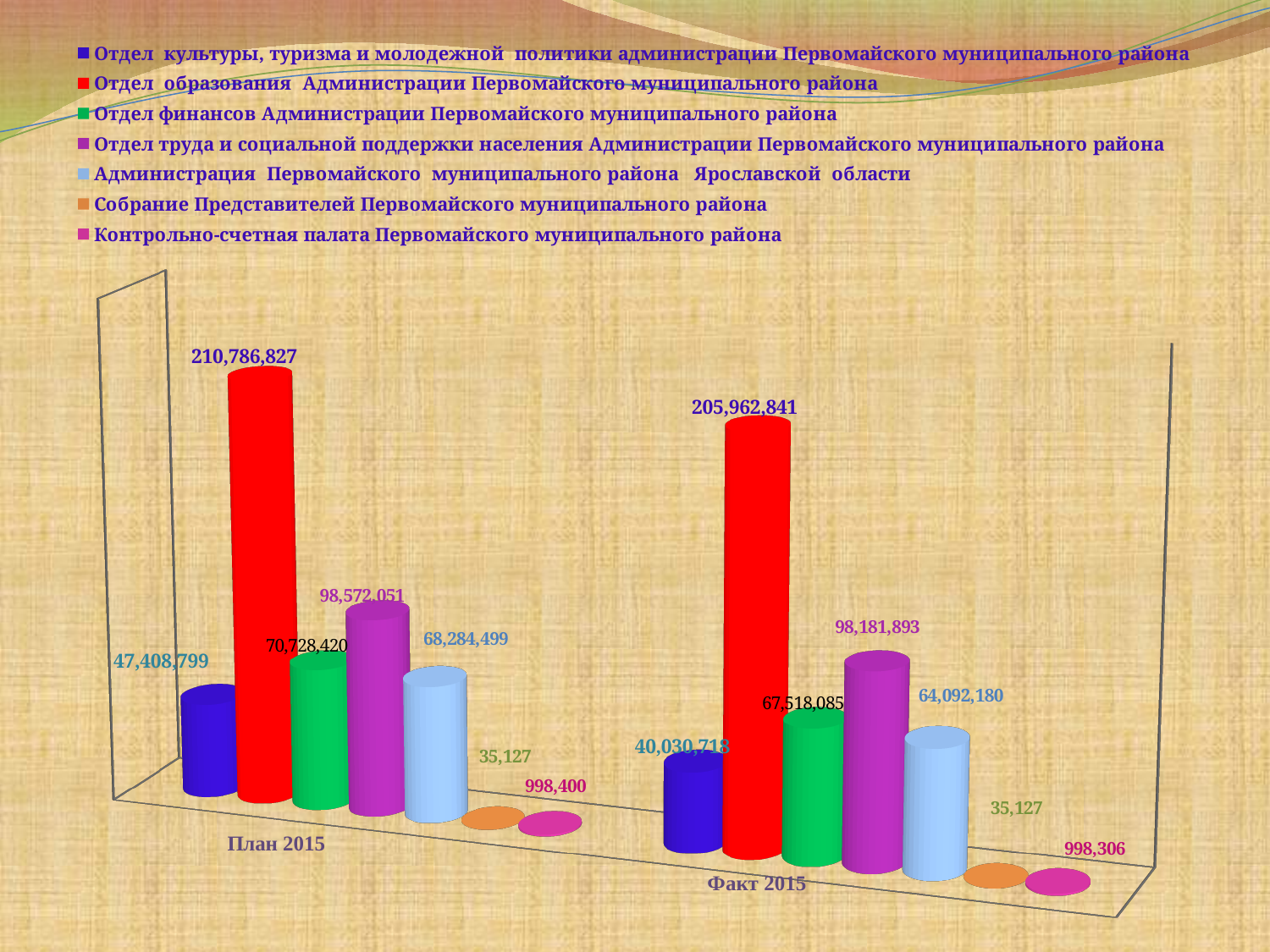
What is the value for Отдел труда и социальной поддержки населения in Факт 2015? 98,181,893 How many series does the legend list? 7 Which is larger for Отдел финансов: the План 2015 value or the Факт 2015 value? План 2015 What kind of chart is shown on the slide? Bar chart Which series has the lowest value in Факт 2015? Собрание Представителей Первомайского муниципального района What is the difference between the План 2015 and Факт 2015 values for Отдел образования? 4,823,986 Which series has the highest value in План 2015? Отдел образования Администрации Первомайского муниципального района What is the value for Контрольно-счетная палата Первомайского муниципального района in План 2015? 998,400 What is the value for Отдел образования Администрации Первомайского муниципального района in Факт 2015? 205,962,841 What is the value for Отдел образования Администрации Первомайского муниципального района in План 2015? 210,786,827 What is the value for Администрация Первомайского муниципального района Ярославской области in Факт 2015? 64,092,180 What is the difference between the План 2015 and Факт 2015 values for Отдел культуры, туризма и молодежной политики? 7,378,081